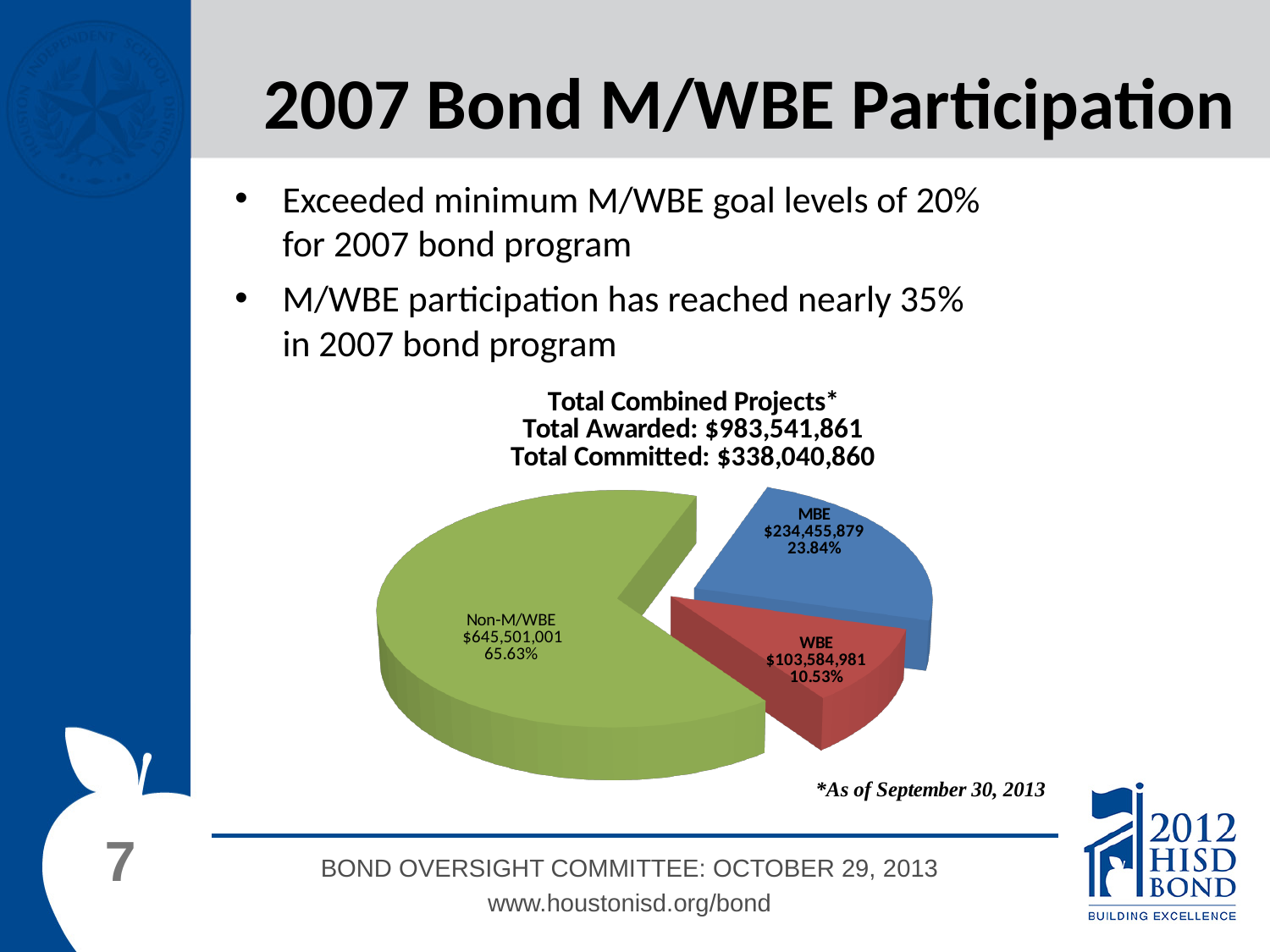
Which slice of the pie chart is the smallest? WBE What kind of chart is shown on the slide? pie chart Which slice of the pie chart is the largest? Non-M/WBE What dollar amount is shown for the MBE slice? $234,455,879 What dollar amount is shown for the WBE slice? $103,584,981 How many slices does the pie chart have? 3 What share of the pie does the Non-M/WBE slice represent? 65.63% What share of the pie does the MBE slice represent? 23.84% What dollar amount is shown for the Non-M/WBE slice? $645,501,001 What Total Awarded amount is shown in the chart title? $983,541,861 Which is larger, the MBE slice or the WBE slice? MBE What share of the pie does the WBE slice represent? 10.53%